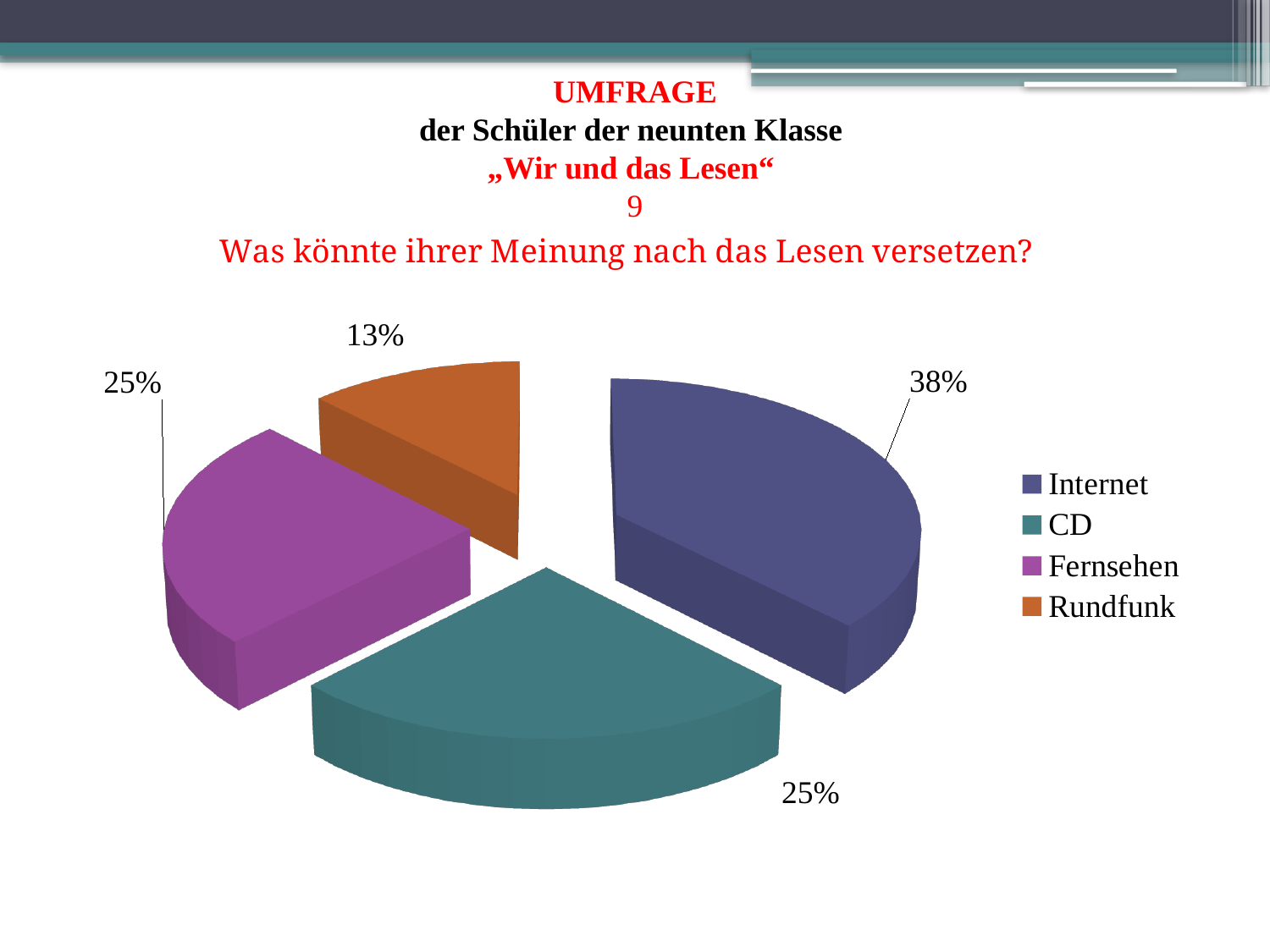
How many entries does the legend list? 4 What share of the pie does CD have? 25% What share of the pie does Rundfunk have? 13% What share of the pie does Internet have? 38% Which is larger, the slice for Internet or the slice for Fernsehen? Internet What is the difference in percentage points between Internet and Rundfunk? 25 What colour is the slice for Rundfunk? orange Which category has the smallest slice of the pie? Rundfunk How many slices does the pie chart have? 4 What share of the pie does Fernsehen have? 25% What kind of chart is shown on the slide? pie chart Which category has the largest slice of the pie? Internet